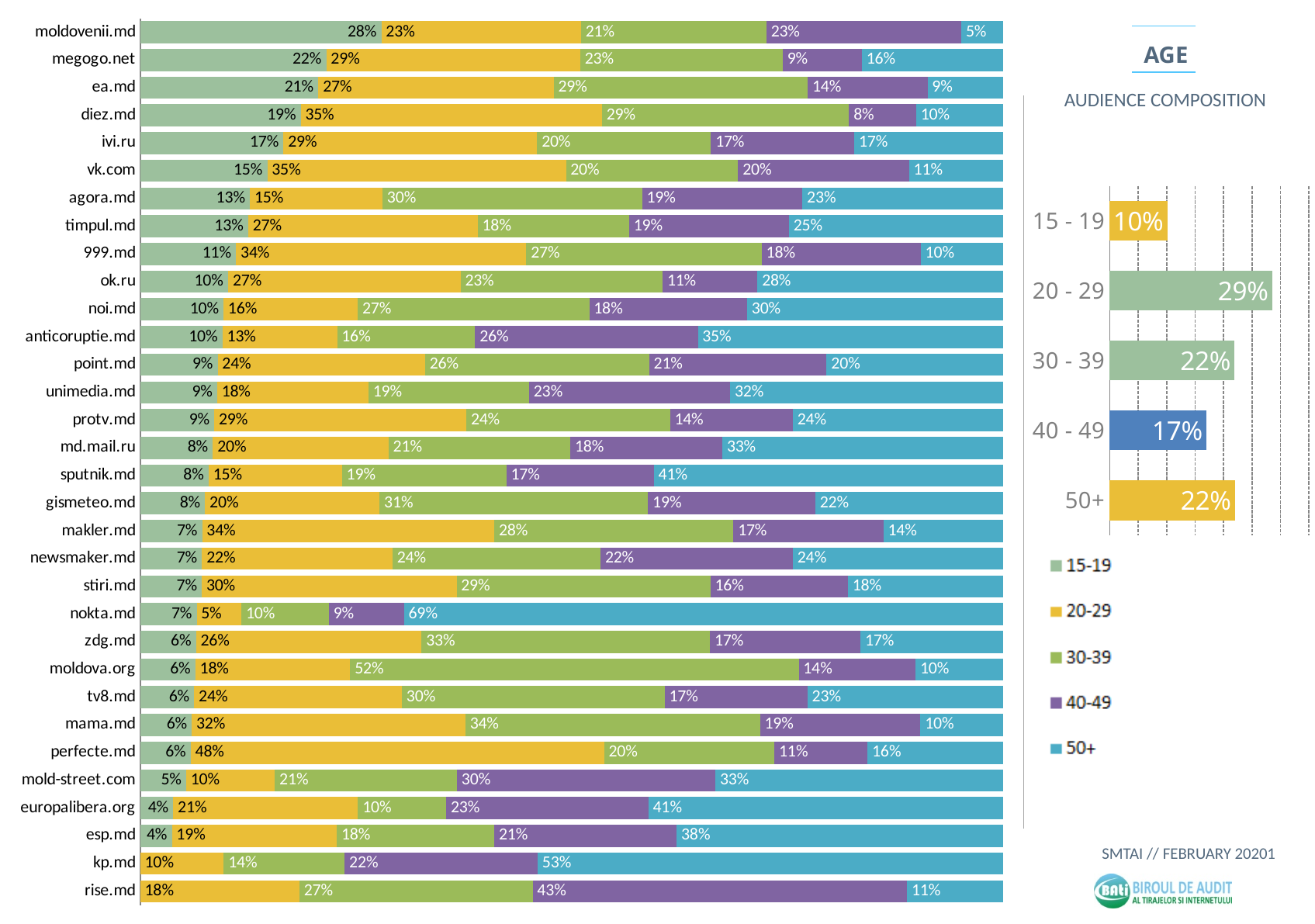
In the left stacked bar chart, what is the difference in percentage points between moldovenii.md's 15-19 share and its 50+ share? 23 percentage points In the left stacked bar chart, what percentage of nokta.md's audience is aged 50+? 69% In the left stacked bar chart, what share of moldova.org's audience is in the 30-39 age group? 52% In the AGE audience composition chart on the right, what is the share of the 40 - 49 age group? 17% In the left stacked bar chart, which website has the highest 50+ share? nokta.md In the left stacked bar chart, which has a larger 30-39 share: moldova.org or agora.md? moldova.org What type of chart is the AGE audience composition chart on the right? Bar chart How many websites are listed in the left stacked bar chart? 32 In the left stacked bar chart, what is the 20-29 share for perfecte.md? 48% In the AGE audience composition chart on the right, which age group has the largest share? 20 - 29 In the left stacked bar chart, which website has the highest share of 15-19 year olds? moldovenii.md How many age groups does the legend of the left stacked bar chart list? 5